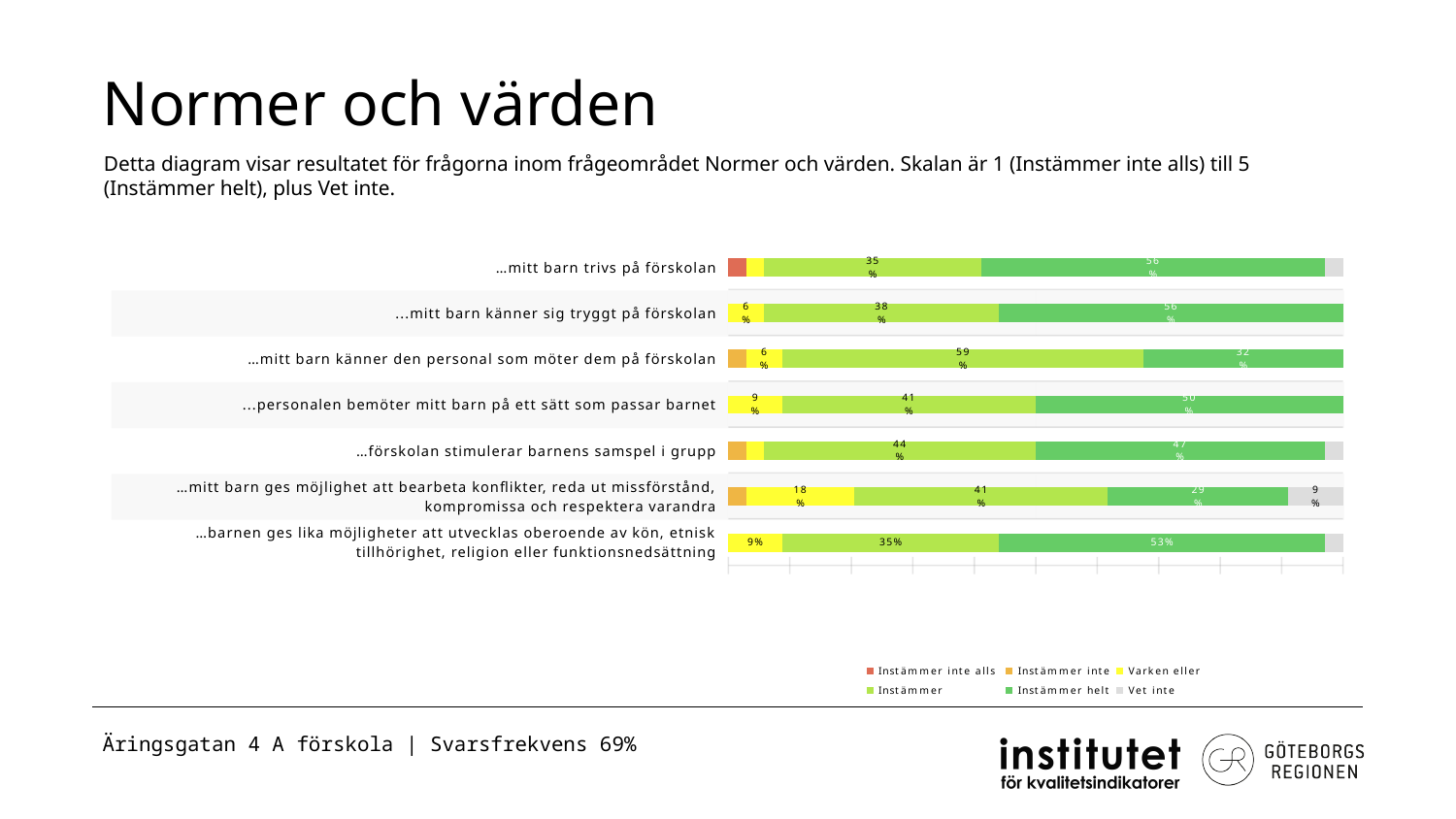
What is the 'Instämmer' share for '…mitt barn känner den personal som möter dem på förskolan'? 59% Which statement has the highest 'Instämmer' share? …mitt barn känner den personal som möter dem på förskolan Which statement has the lowest 'Instämmer helt' share? …mitt barn ges möjlighet att bearbeta konflikter, reda ut missförstånd, kompromissa och respektera varandra What is the 'Varken eller' share for '…mitt barn ges möjlighet att bearbeta konflikter, reda ut missförstånd, kompromissa och respektera varandra'? 18% For '…mitt barn trivs på förskolan', how many percentage points larger is the 'Instämmer helt' share than the 'Instämmer' share? 21 percentage points How many series does the legend list? 6 What kind of chart is shown on the slide? Stacked bar chart How many statements (categories) are plotted in the chart? 7 What is the 'Vet inte' share for '…mitt barn ges möjlighet att bearbeta konflikter, reda ut missförstånd, kompromissa och respektera varandra'? 9% What is the 'Instämmer helt' share for '…mitt barn trivs på förskolan'? 56% What is the title of the slide containing the chart? Normer och värden Which has the larger 'Instämmer helt' share: '…barnen ges lika möjligheter att utvecklas oberoende av kön, etnisk tillhörighet, religion eller funktionsnedsättning' or '…personalen bemöter mitt barn på ett sätt som passar barnet'? …barnen ges lika möjligheter att utvecklas oberoende av kön, etnisk tillhörighet, religion eller funktionsnedsättning